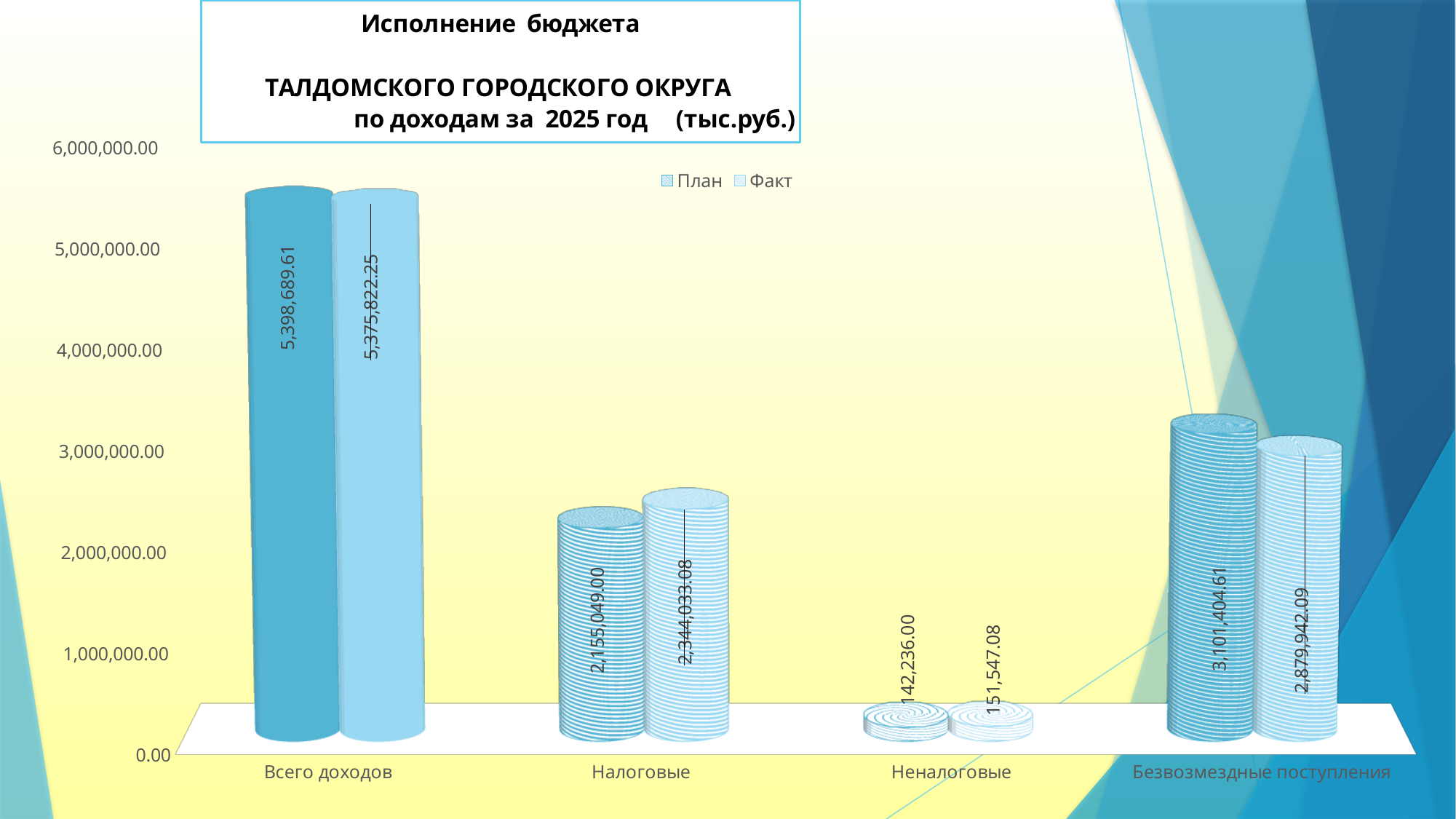
What is the Факт value for Налоговые? 2,344,033.08 What is the difference between the План and Факт values for Безвозмездные поступления? 221,462.52 How many series does the legend list? 2 What is the difference between the Факт and План values for Налоговые? 188,984.08 For Безвозмездные поступления, which is larger: План or Факт? План What is the План value for Неналоговые? 142,236.00 Which category has the highest План value? Всего доходов What kind of chart is shown on the slide? Bar chart Which category has the lowest Факт value? Неналоговые What is the Факт value for Безвозмездные поступления? 2,879,942.09 What is the План value for Всего доходов? 5,398,689.61 How many categories are shown on the x axis? 4